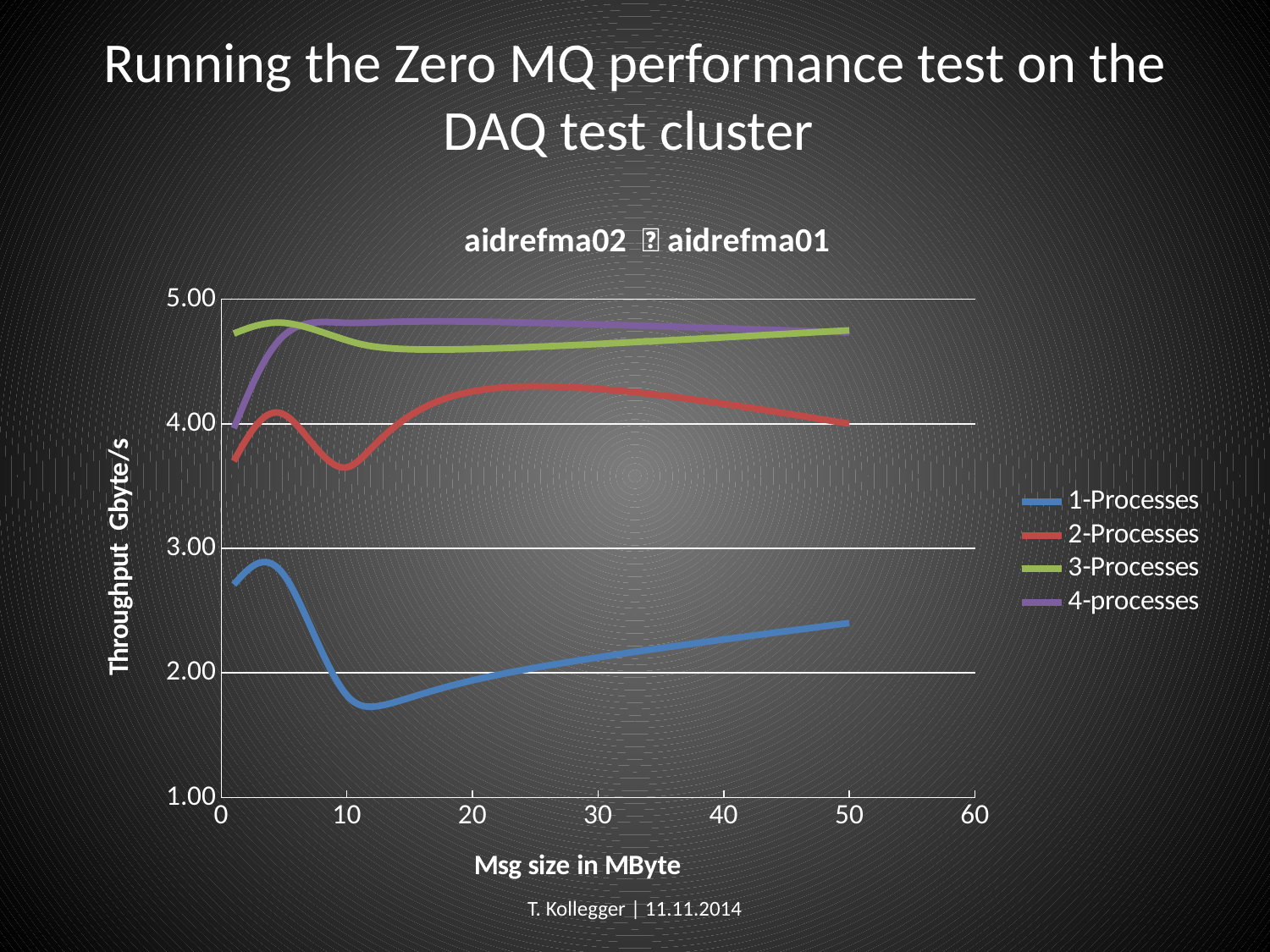
Is the throughput for 1-Processes at a message size of 10 MByte greater or less than 2.00? less What kind of chart is shown on the slide? line chart Which series has the highest throughput at a message size of 30 MByte? 4-processes Is the throughput for 3-Processes at a message size of 20 MByte greater or less than 4.00? greater What is the title of the x axis? Msg size in MByte Which series has the lowest throughput at a message size of 30 MByte? 1-Processes Is the throughput for 1-Processes at a message size of 50 MByte greater or less than 2.00? greater Does the throughput for 1-Processes rise or fall as the message size increases from 20 to 50 MByte? rises At a message size of 50 MByte, which has the higher throughput: 3-Processes or 2-Processes? 3-Processes How many series does the legend list? 4